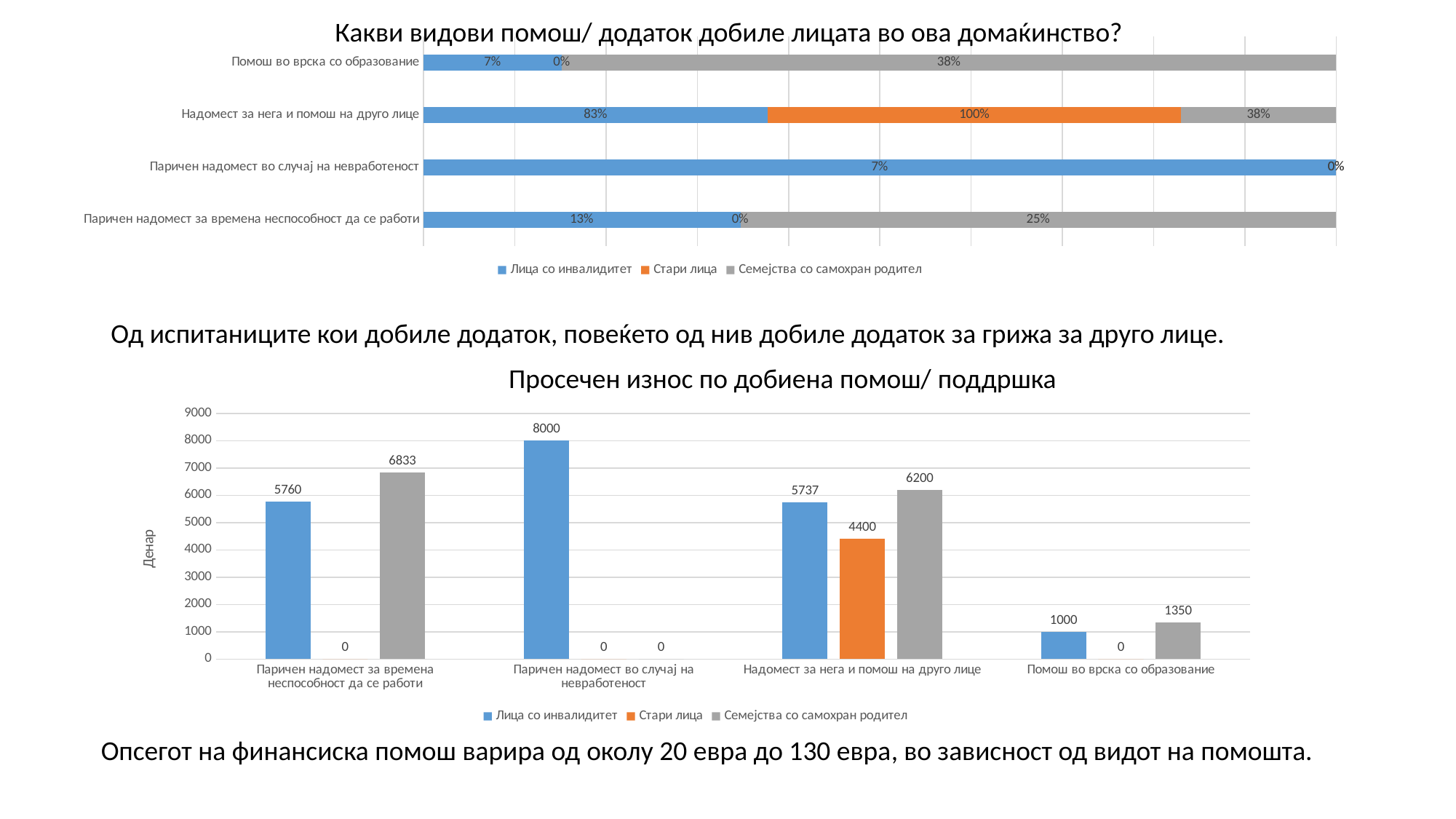
In the chart titled "Просечен износ по добиена помош/ поддршка", what is the difference between the Семејства со самохран родител value and the Лица со инвалидитет value in the category Надомест за нега и помош на друго лице? 463 What kind of chart is the top chart titled "Какви видови помош/ додаток добиле лицата во ова домаќинство?"? Stacked bar chart In the top chart titled "Какви видови помош/ додаток добиле лицата во ова домаќинство?", how many series does the legend list? 3 In the chart titled "Просечен износ по добиена помош/ поддршка", which is larger in the category Паричен надомест за времена неспособност да се работи: Лица со инвалидитет or Семејства со самохран родител? Семејства со самохран родител In the top chart titled "Какви видови помош/ додаток добиле лицата во ова домаќинство?", what is the value for Стари лица in the category Надомест за нега и помош на друго лице? 100% In the top chart titled "Какви видови помош/ додаток добиле лицата во ова домаќинство?", what is the value for Семејства со самохран родител in the category Паричен надомест за времена неспособност да се работи? 25% In the chart titled "Просечен износ по добиена помош/ поддршка", what is the value for Стари лица in the category Надомест за нега и помош на друго лице? 4400 In the chart titled "Просечен износ по добиена помош/ поддршка", what is the label of the vertical axis? Денар In the chart titled "Просечен износ по добиена помош/ поддршка", what is the value for Семејства со самохран родител in the category Помош во врска со образование? 1350 In the chart titled "Просечен износ по добиена помош/ поддршка", what is the value for Лица со инвалидитет in the category Паричен надомест во случај на невработеност? 8000 In the chart titled "Просечен износ по добиена помош/ поддршка", how many categories are shown on the x axis? 4 In the chart titled "Просечен износ по добиена помош/ поддршка", which category has the highest value for Семејства со самохран родител? Паричен надомест за времена неспособност да се работи